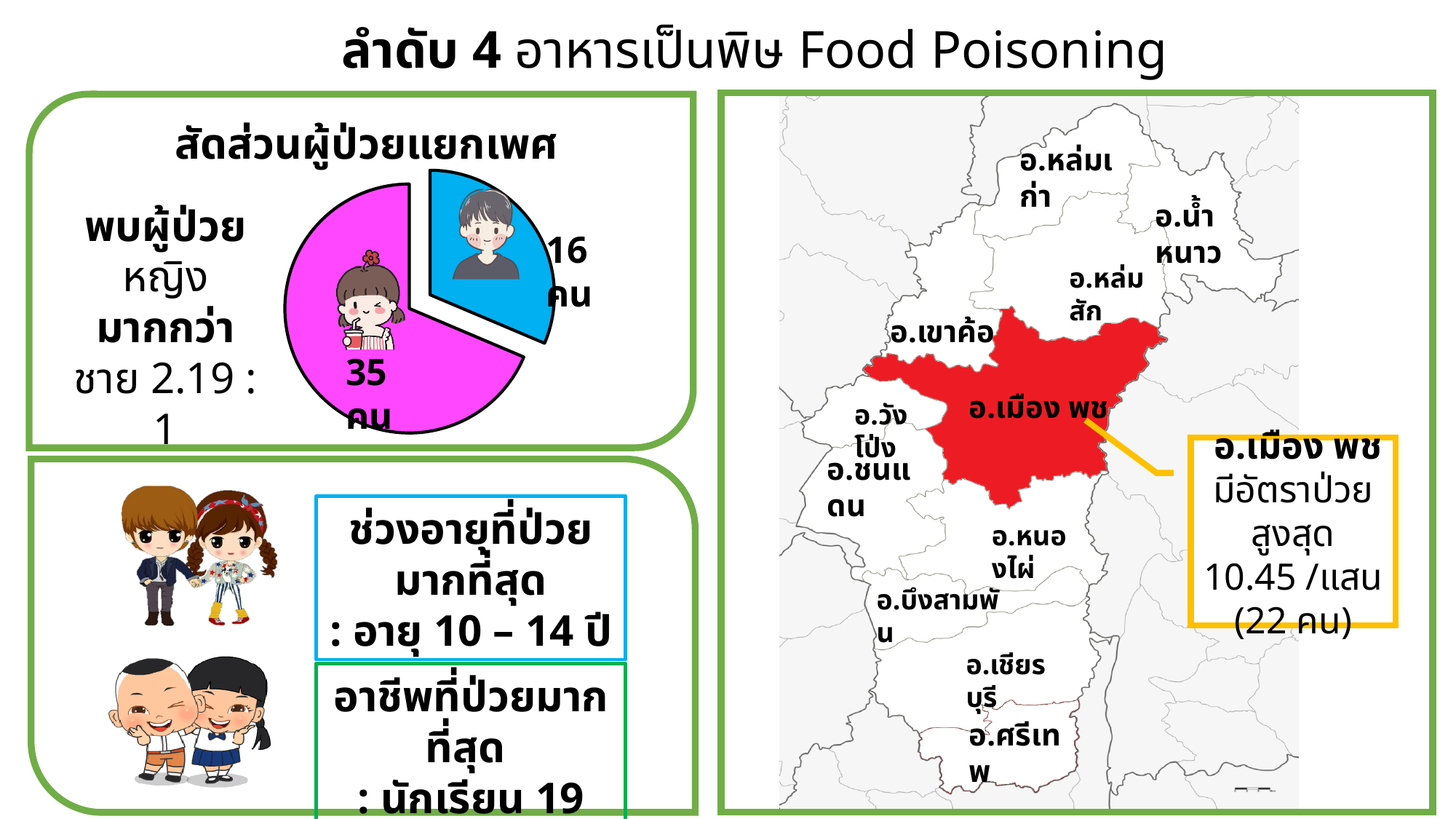
In the pie chart สัดส่วนผู้ป่วยแยกเพศ, which group has the larger slice? หญิง (female) In the pie chart สัดส่วนผู้ป่วยแยกเพศ, how many patients are male (ชาย)? 16 คน How many slices does the pie chart สัดส่วนผู้ป่วยแยกเพศ have? 2 In the pie chart สัดส่วนผู้ป่วยแยกเพศ, how many more female patients are there than male patients? 19 คน What is the title of the pie chart on the left of the slide? สัดส่วนผู้ป่วยแยกเพศ What kind of chart is shown under the title สัดส่วนผู้ป่วยแยกเพศ? Pie chart In the pie chart สัดส่วนผู้ป่วยแยกเพศ, is the number of female patients larger or smaller than the number of male patients? Larger In the pie chart สัดส่วนผู้ป่วยแยกเพศ, what colour is the slice for male patients (16 คน)? Blue What is the total number of patients shown in the pie chart สัดส่วนผู้ป่วยแยกเพศ? 51 คน In the pie chart สัดส่วนผู้ป่วยแยกเพศ, which group has the smaller slice? ชาย (male) In the pie chart สัดส่วนผู้ป่วยแยกเพศ, how many patients are female (หญิง)? 35 คน